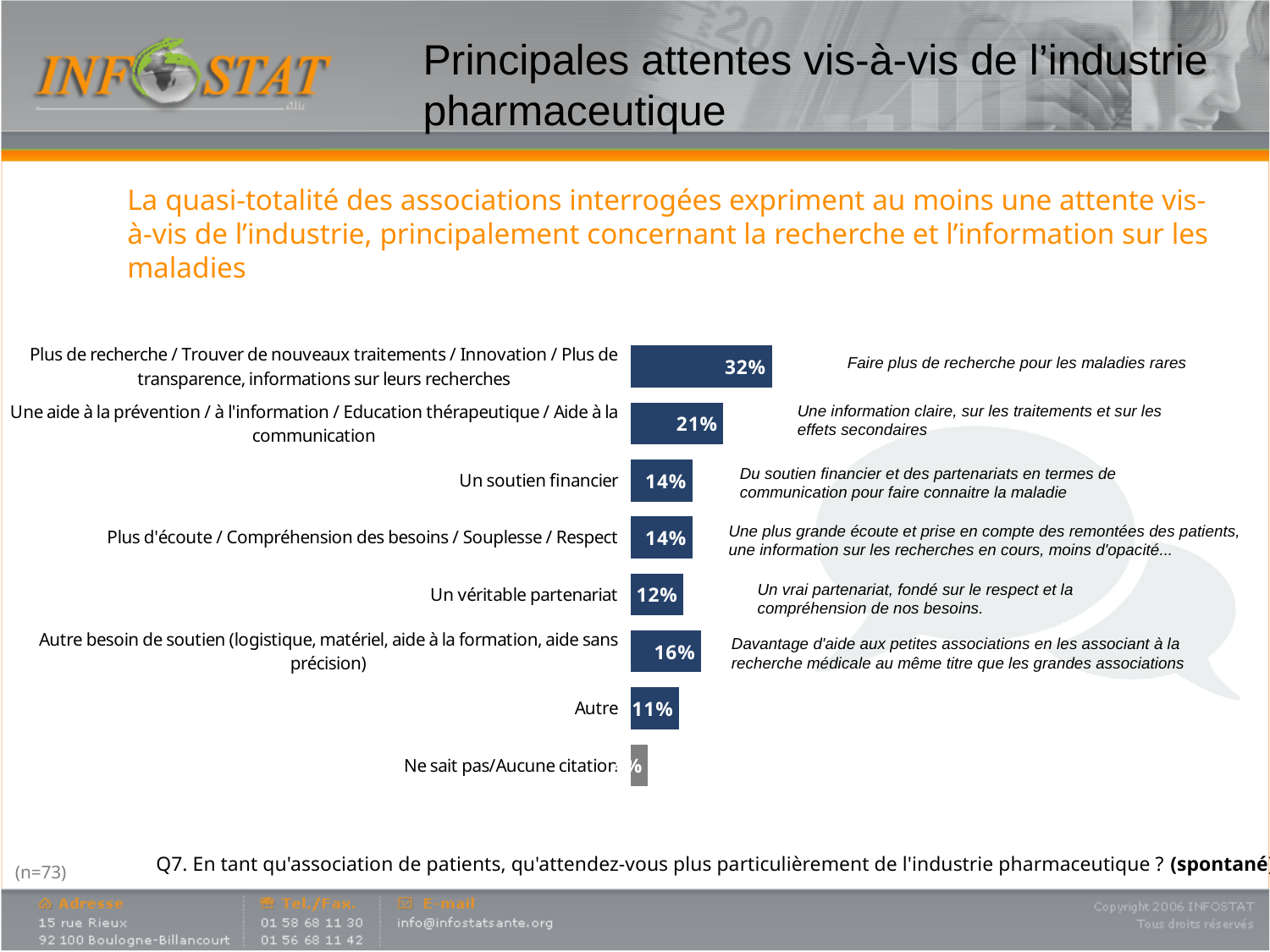
Which category has the highest percentage? Plus de recherche / Trouver de nouveaux traitements / Innovation / Plus de transparence, informations sur leurs recherches What colour are the bars in the chart? Dark blue Which is larger: the value for "Autre besoin de soutien" or the value for "Un véritable partenariat"? Autre besoin de soutien What is the difference between the value for "Plus de recherche / Trouver de nouveaux traitements / Innovation / Plus de transparence, informations sur leurs recherches" and the value for "Une aide à la prévention / à l'information / Education thérapeutique / Aide à la communication"? 11% What value is shown for "Un véritable partenariat"? 12% What percentage is shown for "Autre"? 11% What is the difference between the value for "Un soutien financier" and the value for "Autre"? 3% How many categories are plotted in the bar chart? 8 What value is shown for "Autre besoin de soutien (logistique, matériel, aide à la formation, aide sans précision)"? 16% What type of chart is shown on the slide? Bar chart What is the sample size indicated on the slide? n=73 What percentage is shown for "Un soutien financier"? 14%